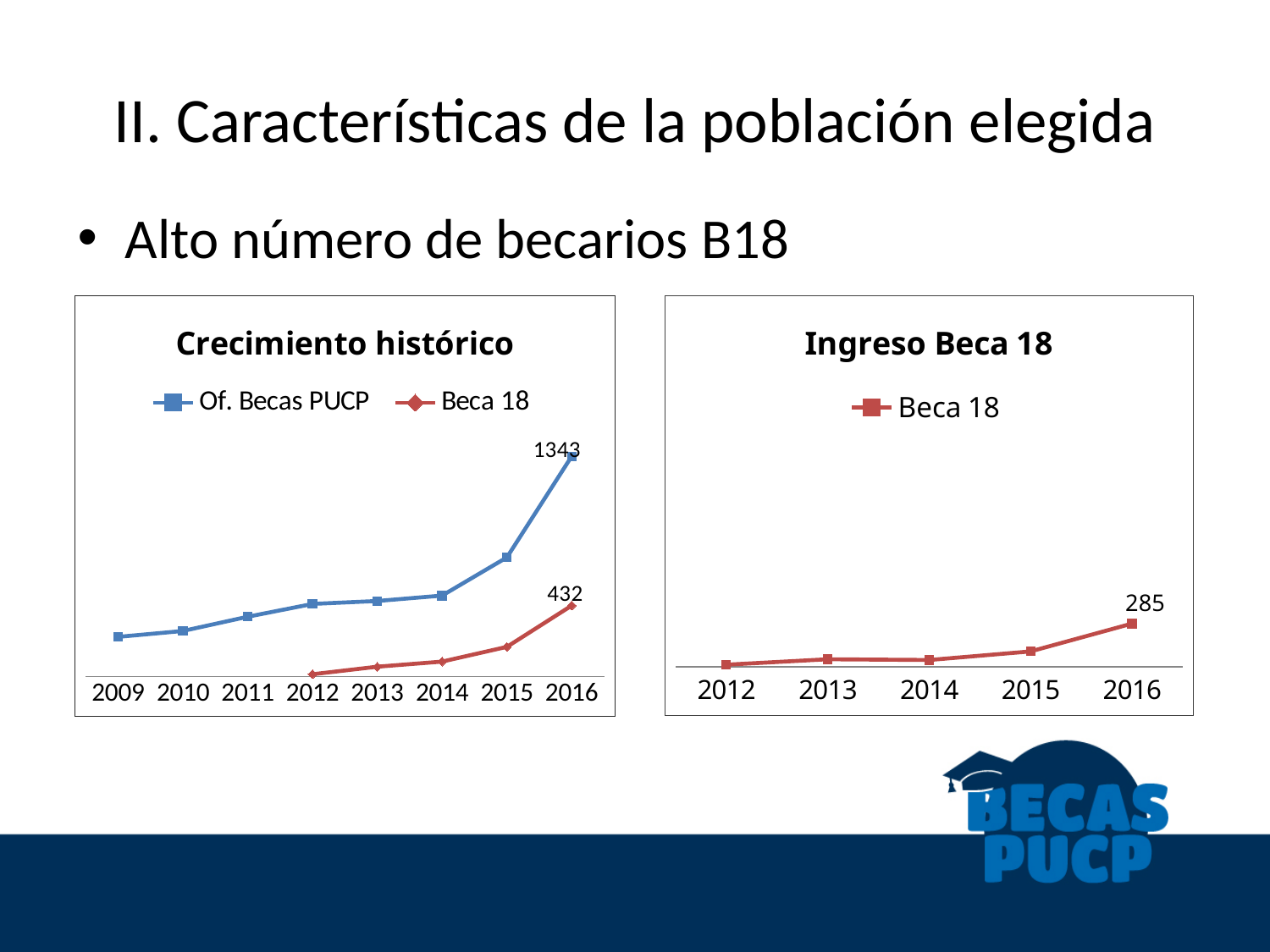
In the 'Crecimiento histórico' chart, which year has the highest value for Of. Becas PUCP? 2016 How many series does the legend of the 'Crecimiento histórico' chart list? 2 In the 'Ingreso Beca 18' chart, do the values generally rise or fall from 2012 to 2016? Rise How many years are shown on the x axis of the 'Ingreso Beca 18' chart? 5 How many years are shown on the x axis of the 'Crecimiento histórico' chart? 8 In the 'Crecimiento histórico' chart, what is the value for Of. Becas PUCP in 2016? 1343 In the 'Crecimiento histórico' chart, what is the value for Beca 18 in 2016? 432 In the 'Ingreso Beca 18' chart, what is the value for Beca 18 in 2016? 285 In the 'Crecimiento histórico' chart, what is the difference between the 2016 values of Of. Becas PUCP and Beca 18? 911 What kind of chart is the 'Ingreso Beca 18' chart? Line chart In the 'Crecimiento histórico' chart, which year has the lowest value for Beca 18? 2012 In the 'Crecimiento histórico' chart, which series has the higher value in 2016, Of. Becas PUCP or Beca 18? Of. Becas PUCP